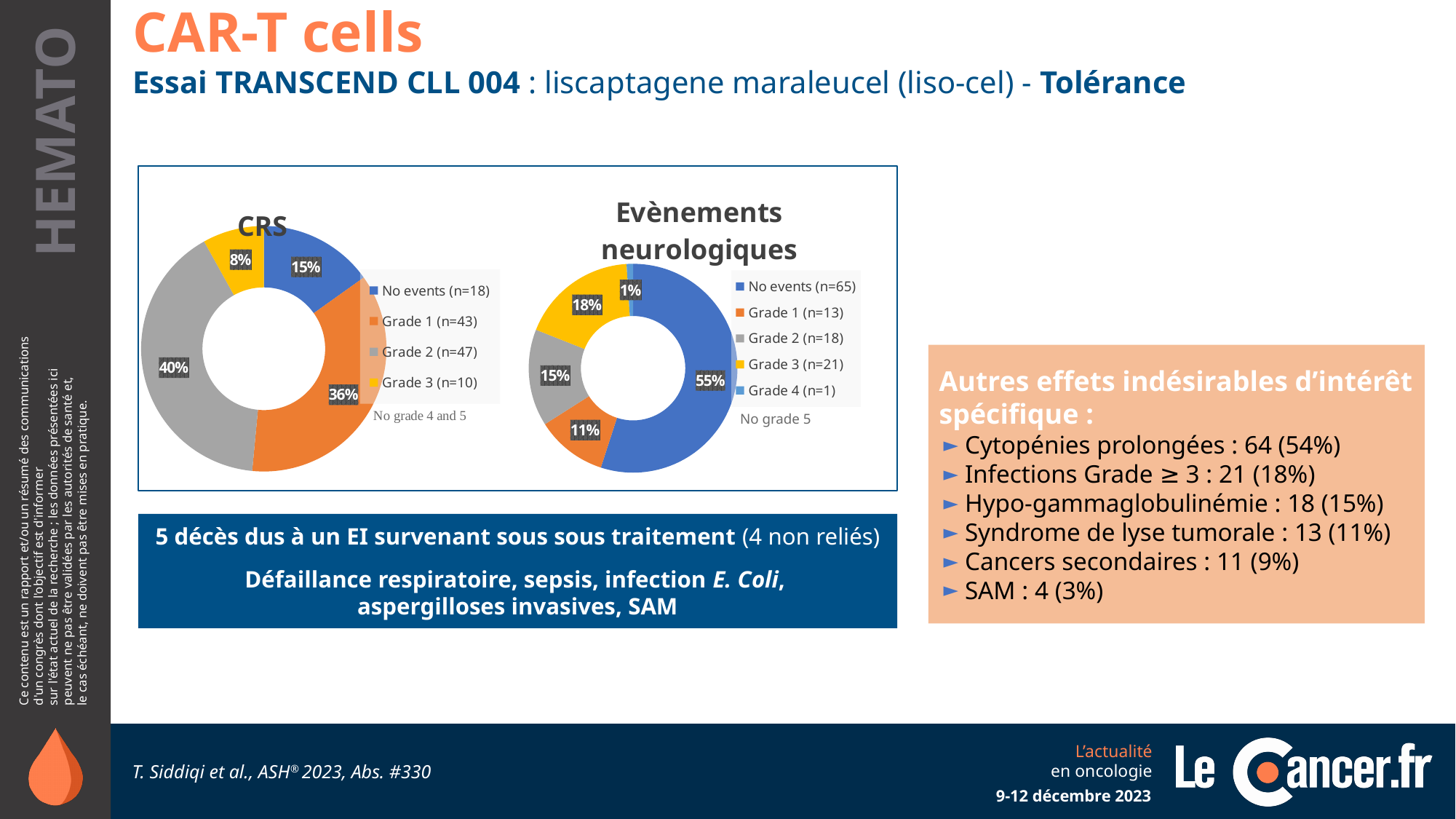
What note appears below the legend of the CRS chart? No grade 4 and 5 In the CRS chart, what percentage is shown for Grade 2 (n=47)? 40% How many categories does the legend of the Evènements neurologiques chart list? 5 In the Evènements neurologiques chart, which category has the smallest share? Grade 4 (n=1) In the CRS chart, which category has the largest share? Grade 2 (n=47) In the Evènements neurologiques chart, what percentage is shown for Grade 3 (n=21)? 18% In the Evènements neurologiques chart, which is larger: Grade 2 (n=18) or Grade 1 (n=13)? Grade 2 (n=18) What type of chart is the CRS chart? Donut (pie) chart In the CRS chart, what percentage is shown for Grade 3 (n=10)? 8% In the Evènements neurologiques chart, what percentage is shown for No events (n=65)? 55% How many categories does the legend of the CRS chart list? 4 In the CRS chart, what is the difference in percentage points between Grade 1 (n=43) and No events (n=18)? 21